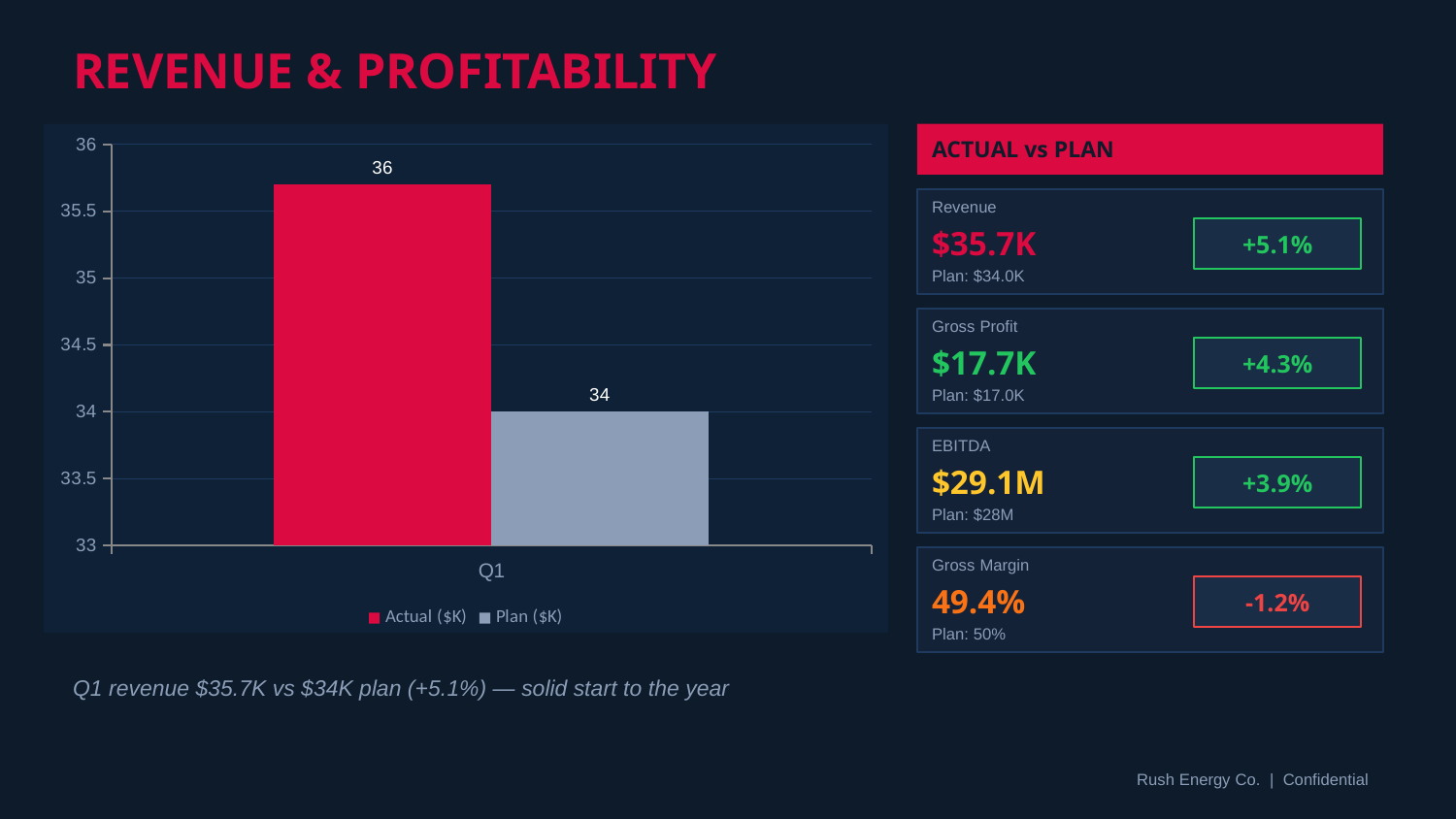
What is the category label on the x axis of the chart? Q1 Which series has the taller bar for Q1, Actual ($K) or Plan ($K)? Actual ($K) Is the Plan ($K) bar for Q1 greater or less than 34.5 on the y axis? less What kind of chart is shown on the slide? bar chart What is the difference between the Actual ($K) and Plan ($K) data labels for Q1? 2 Which series has the lowest bar in the chart? Plan ($K) How many series does the chart legend list? 2 How many categories are shown on the x axis of the chart? 1 Is the Actual ($K) bar for Q1 greater or less than 35 on the y axis? greater What colour is the Actual ($K) bar in the chart? red What is the data label on the Actual ($K) bar for Q1? 36 What is the data label on the Plan ($K) bar for Q1? 34